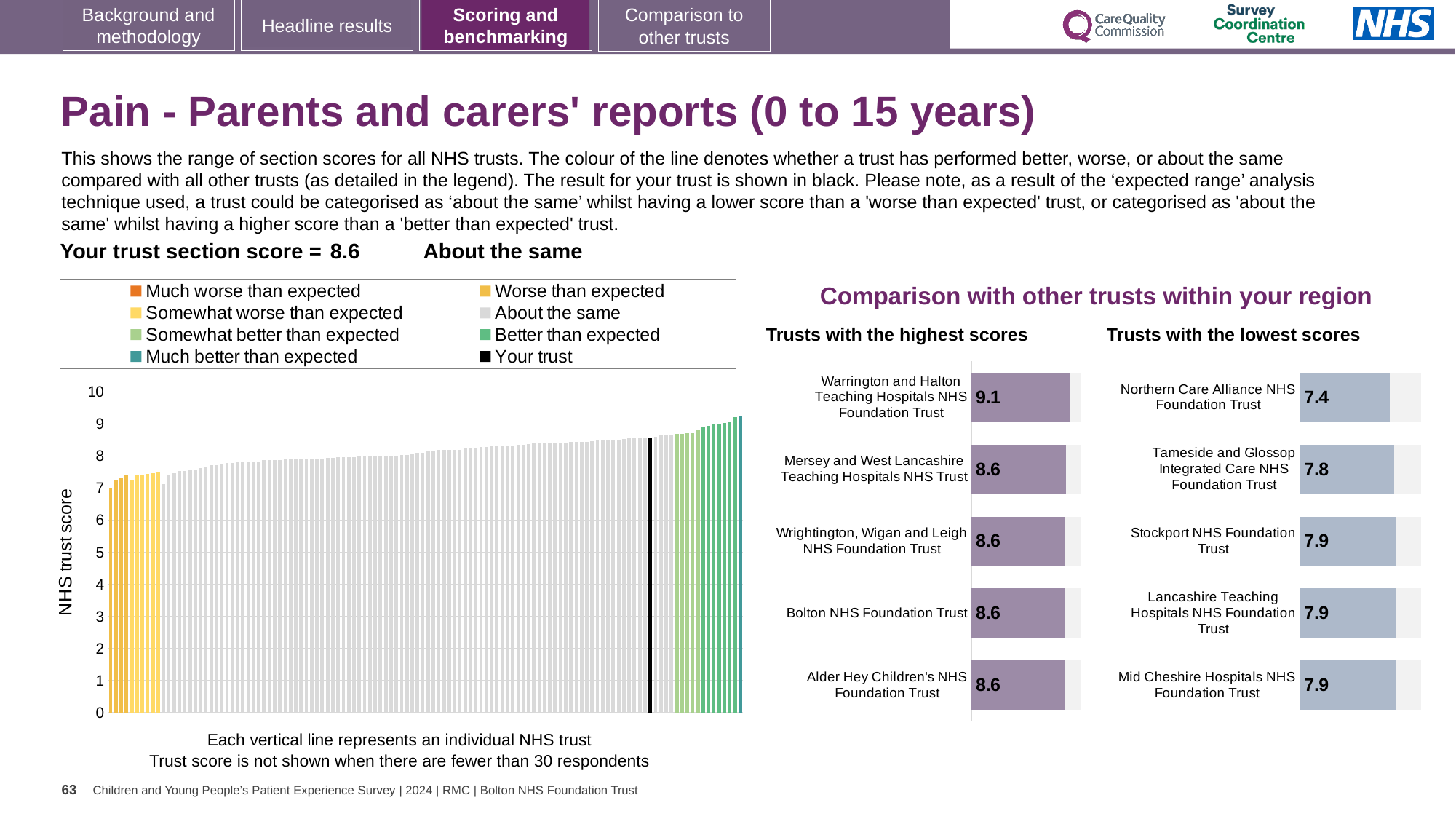
How many entries does the legend above the large chart on the left list? 8 In the 'Trusts with the lowest scores' chart, what is the score for Northern Care Alliance NHS Foundation Trust? 7.4 How many trusts are shown in the 'Trusts with the highest scores' chart? 5 In the 'Trusts with the highest scores' chart, what is the score for Warrington and Halton Teaching Hospitals NHS Foundation Trust? 9.1 In the large chart on the left, do the bar values rise or fall from left to right? rise In the 'Trusts with the highest scores' chart, what is the difference between the scores of Warrington and Halton Teaching Hospitals NHS Foundation Trust and Bolton NHS Foundation Trust? 0.5 In the 'Trusts with the lowest scores' chart, what is the difference between the scores of Tameside and Glossop Integrated Care NHS Foundation Trust and Northern Care Alliance NHS Foundation Trust? 0.4 Which is larger: the score for Stockport NHS Foundation Trust in the 'Trusts with the lowest scores' chart or the score for Mersey and West Lancashire Teaching Hospitals NHS Trust in the 'Trusts with the highest scores' chart? Mersey and West Lancashire Teaching Hospitals NHS Trust In the 'Trusts with the lowest scores' chart, what is the score for Tameside and Glossop Integrated Care NHS Foundation Trust? 7.8 In the 'Trusts with the lowest scores' chart, which trust has the lowest score? Northern Care Alliance NHS Foundation Trust In the large chart on the left, is the value of the black bar representing your trust greater or less than 8? greater In the 'Trusts with the highest scores' chart, which trust has the highest score? Warrington and Halton Teaching Hospitals NHS Foundation Trust